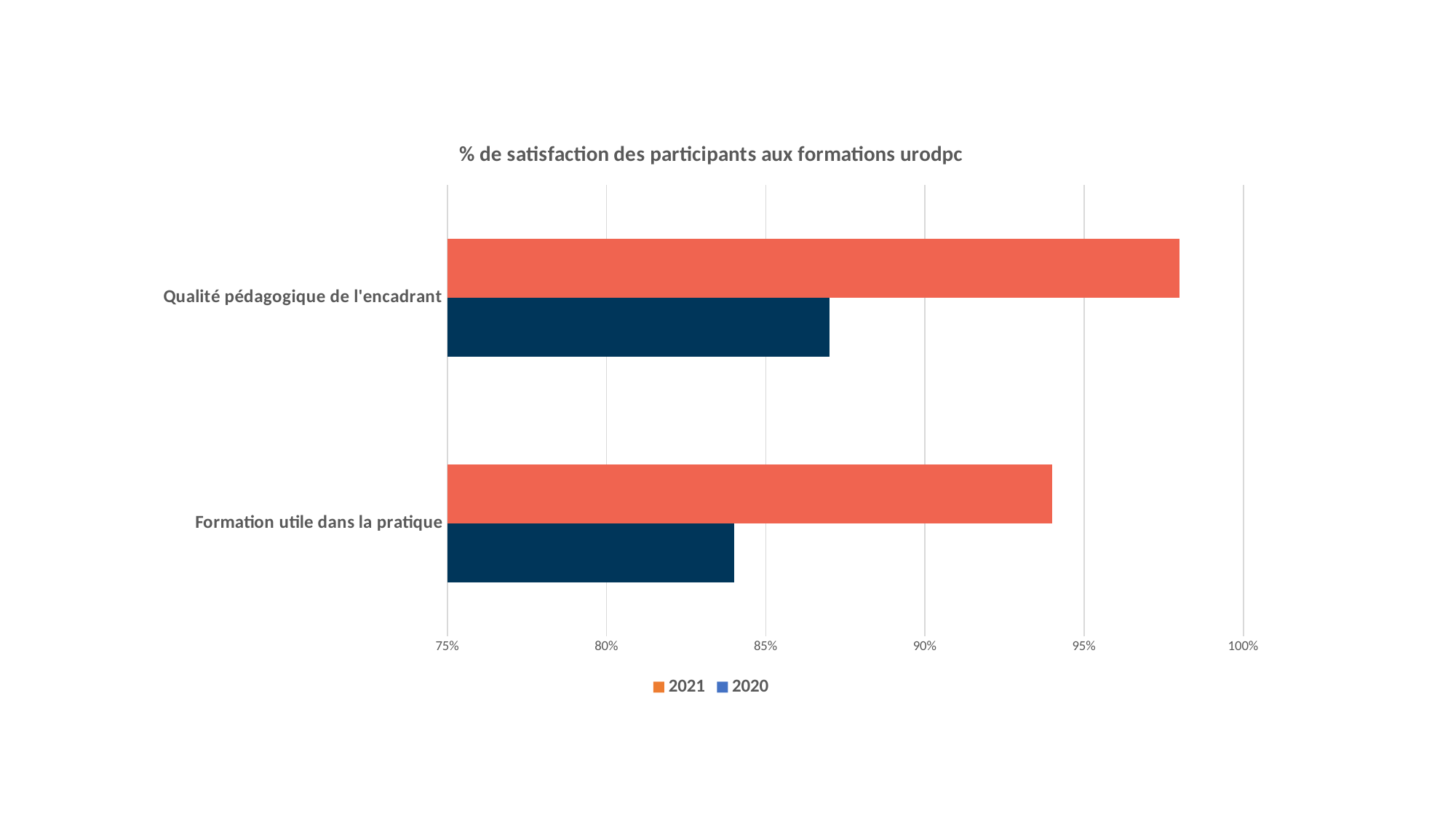
For Qualité pédagogique de l'encadrant, which year has the larger value, 2021 or 2020? 2021 How many categories are shown on the chart? 2 What kind of chart is shown on the slide? bar chart Is the 2021 value for Formation utile dans la pratique greater or less than 90%? greater Is the 2021 value for Qualité pédagogique de l'encadrant greater or less than 95%? greater How many series does the legend list? 2 What is the title of the chart? % de satisfaction des participants aux formations urodpc Which category has the lowest 2021 value? Formation utile dans la pratique Is the 2020 value for Formation utile dans la pratique greater or less than 85%? less Which category has the highest 2020 value? Qualité pédagogique de l'encadrant